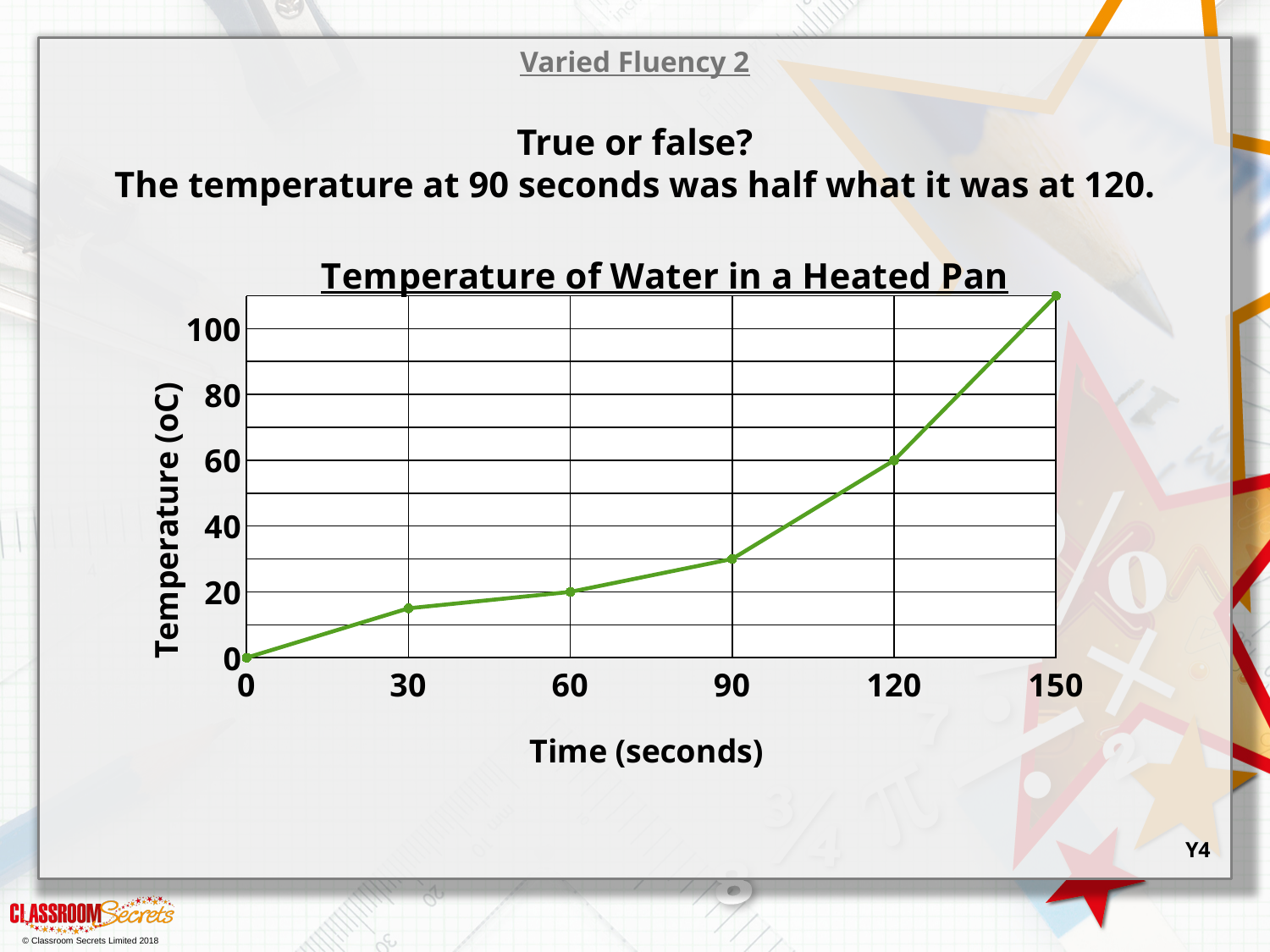
What is the label on the x axis of the chart? Time (seconds) What was the temperature at 60 seconds? 20 What is the title of the chart? Temperature of Water in a Heated Pan At which time was the temperature highest? 150 Is the temperature at 150 seconds greater or less than 100? greater How many data points are plotted on the line? 6 What was the temperature at 0 seconds? 0 At which time was the temperature lowest? 0 Is the temperature at 90 seconds greater or less than 40? less What kind of chart is shown on the slide? line chart What was the temperature at 120 seconds? 60 What is the difference between the temperature at 120 seconds and the temperature at 60 seconds? 40